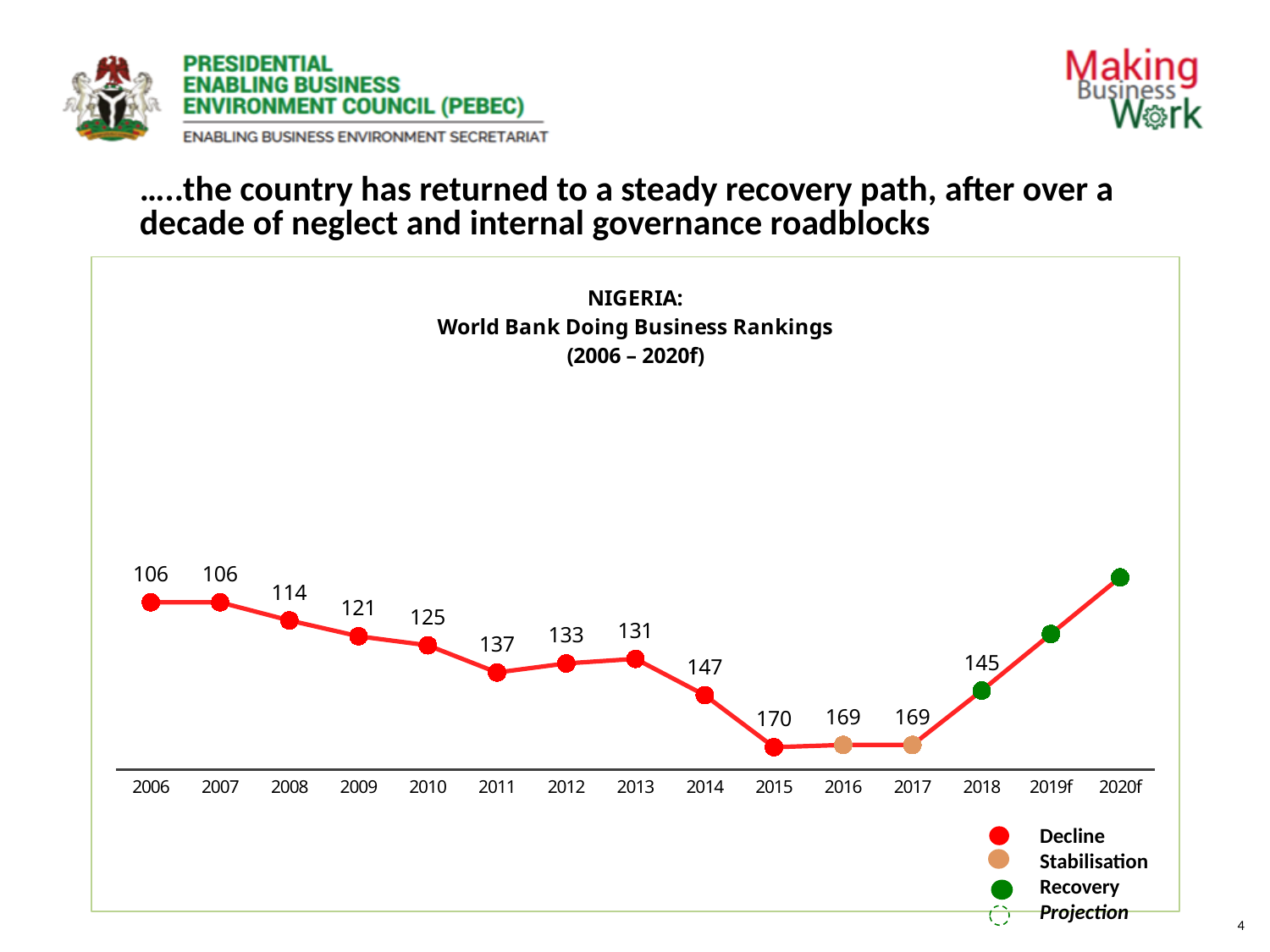
How many years are shown on the x axis? 15 Which has the larger ranking number, 2012 or 2013? 2012 What is the difference between the values for 2017 and 2018? 24 Which year has the highest ranking number on the chart? 2015 What is the ranking value shown for 2018? 145 Do the labelled ranking numbers increase or decrease from 2006 to 2015? Increase What kind of chart is shown on the slide? Line chart What is the ranking value shown for 2010? 125 What is the difference between the values for 2015 and 2014? 23 How many entries does the legend list? 4 What is the ranking value shown for 2008? 114 What is the ranking value shown for 2015? 170